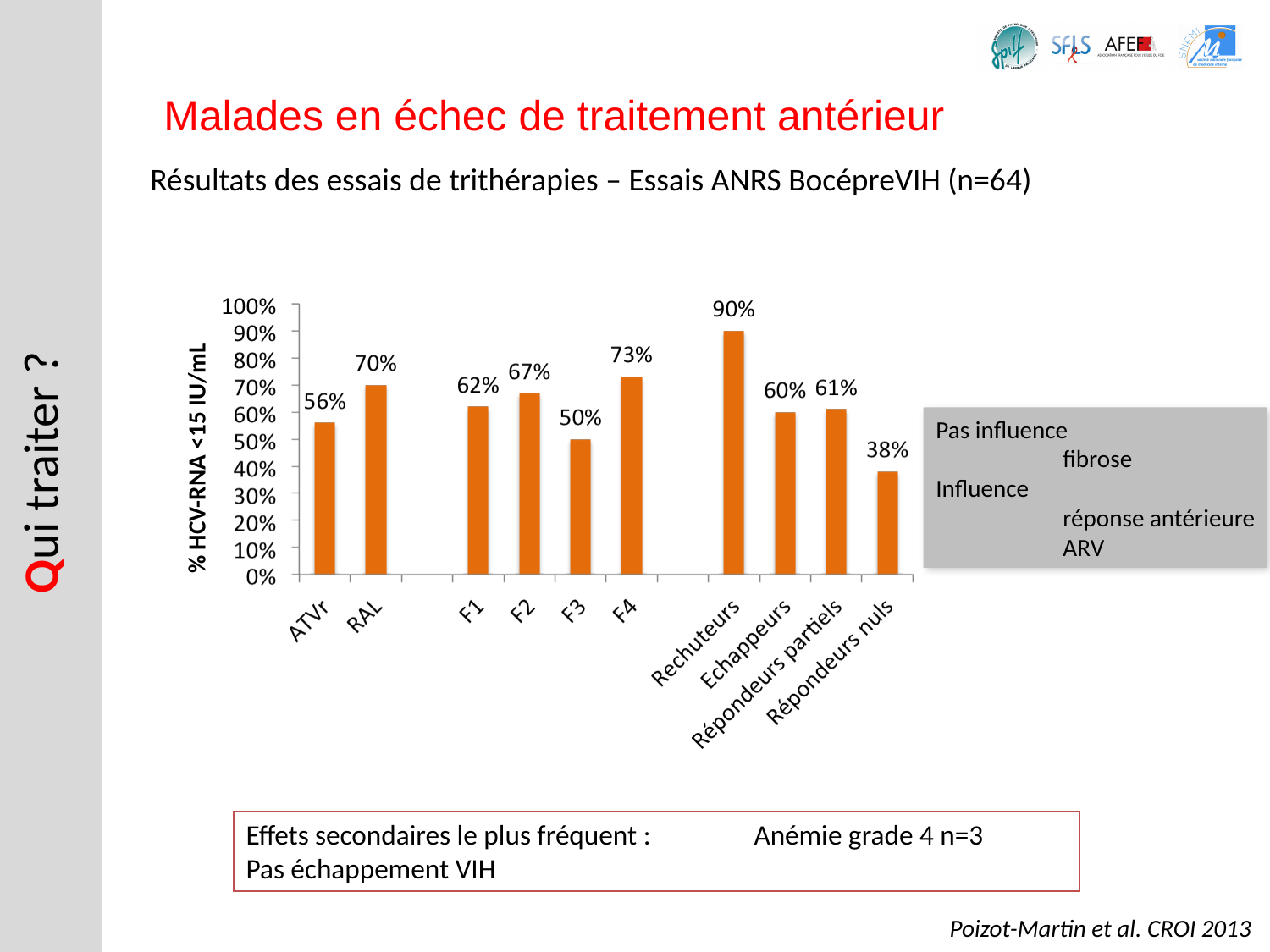
What kind of chart is shown? bar chart Which is larger, the value for F4 or the value for F1? F4 Which category has the lowest value? Répondeurs nuls Is the value for Echappeurs greater or less than 50%? greater What is the difference between the values for Rechuteurs and Répondeurs nuls? 52% Which category has the highest value? Rechuteurs What is the value for RAL? 70% What is the difference between the values for RAL and ATVr? 14% What is the label of the vertical axis? % HCV-RNA <15 IU/mL How many bars are plotted in the chart? 10 What is the value for Répondeurs nuls? 38% What is the value for F3? 50%